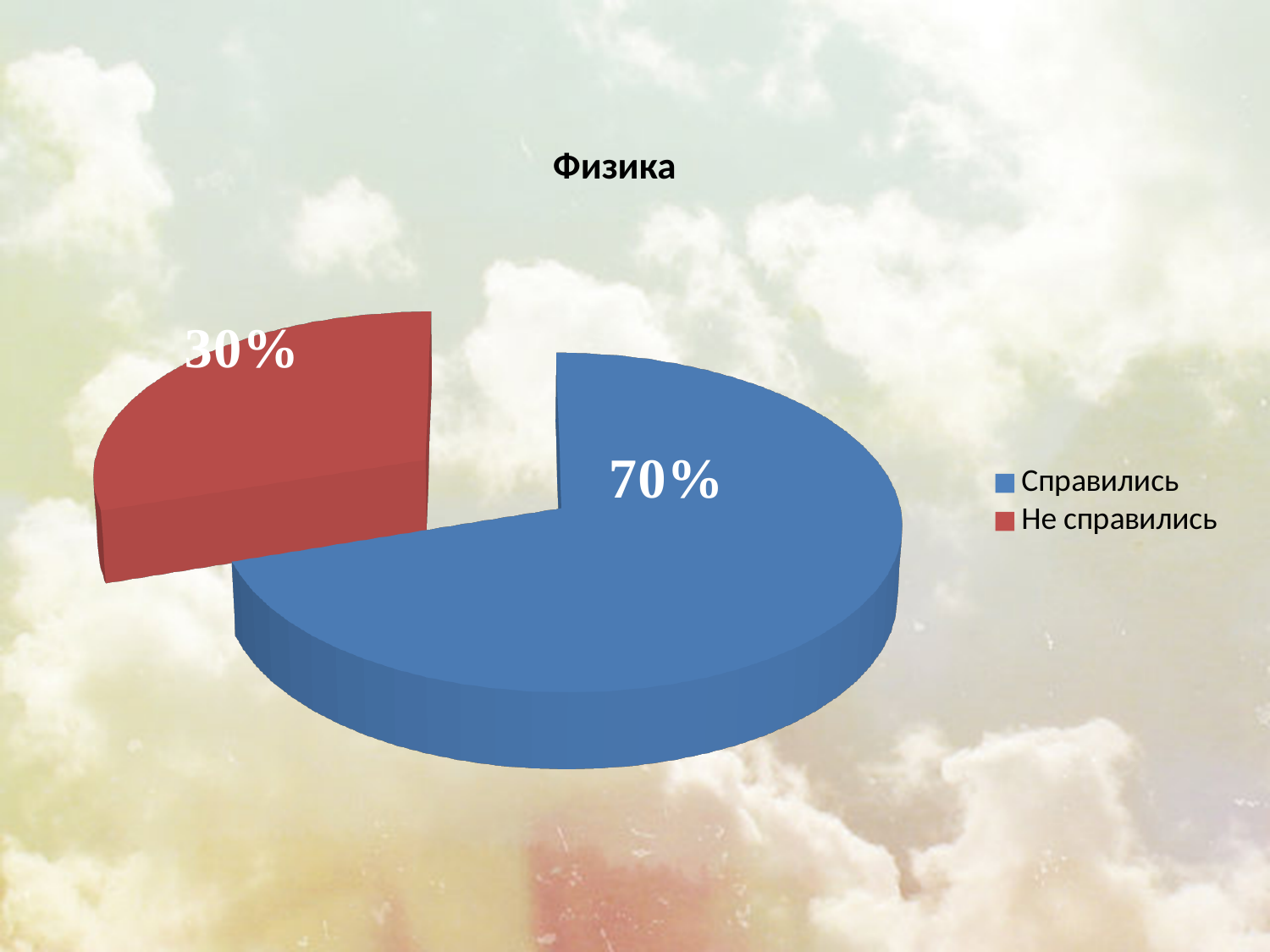
What share of the pie does "Справились" take? 70% What kind of chart is shown on the slide? pie chart What is the title of the chart? Физика How many entries does the legend list? 2 How many slices does the pie chart have? 2 What share of the pie does "Не справились" take? 30% Which category has the smallest slice of the pie? Не справились Which is larger, the share for "Справились" or for "Не справились"? Справились What is the difference in percentage points between "Справились" and "Не справились"? 40% Which category has the largest slice of the pie? Справились What colour is the slice for "Не справились"? red